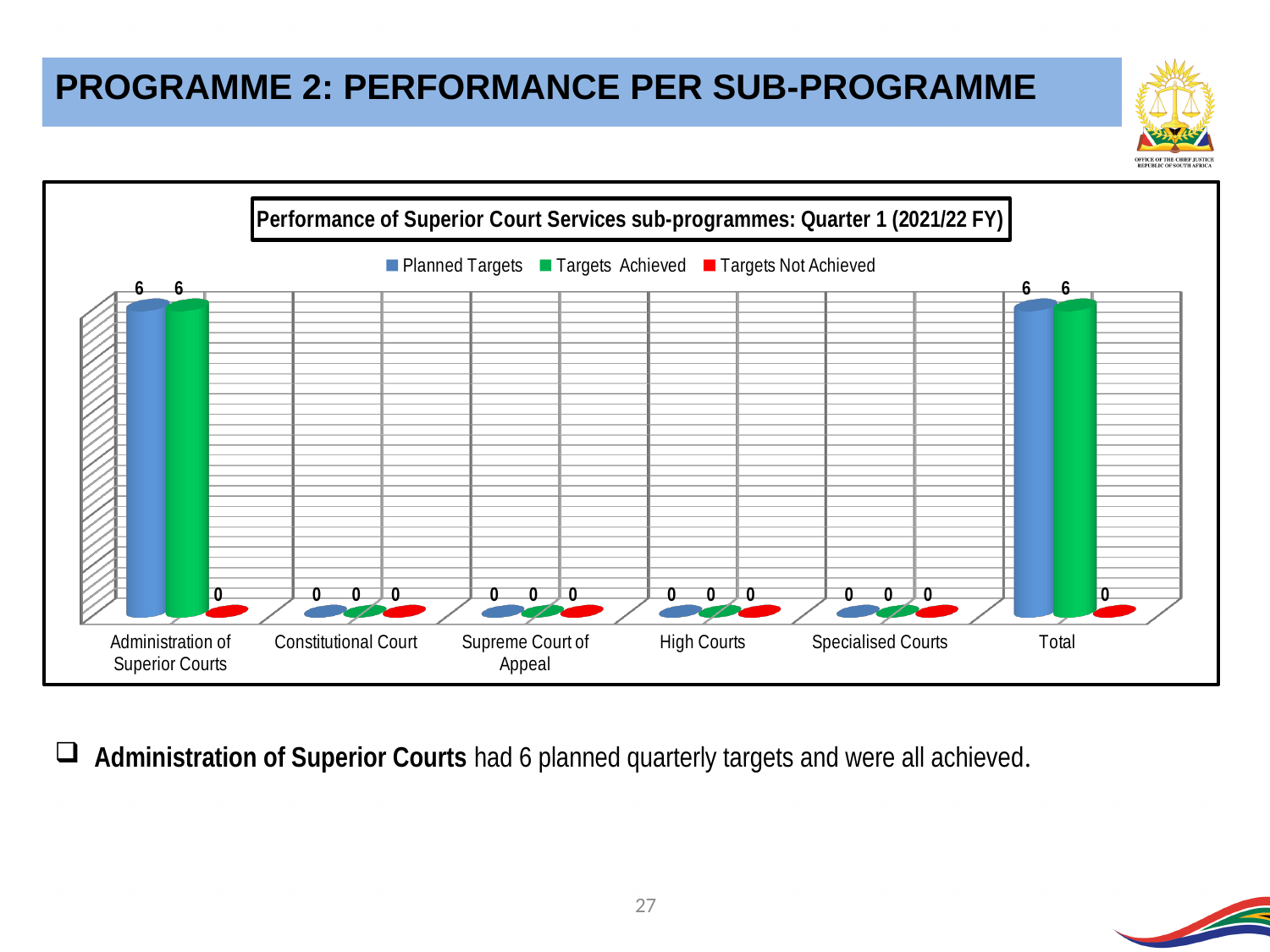
What is the Planned Targets value for Administration of Superior Courts? 6 What is the Targets Achieved value for Constitutional Court? 0 What kind of chart is shown on the slide? Bar chart What is the difference between Planned Targets and Targets Achieved for Administration of Superior Courts? 0 What is the Planned Targets value for High Courts? 0 Which is larger: Planned Targets for Administration of Superior Courts or Planned Targets for Supreme Court of Appeal? Administration of Superior Courts What is the Targets Achieved value for Total? 6 What is the Targets Not Achieved value for Administration of Superior Courts? 0 How many series does the legend list? 3 How many categories are shown on the x axis of the chart? 6 What is the title of the chart? Performance of Superior Court Services sub-programmes: Quarter 1 (2021/22 FY) What is the difference between Planned Targets for Total and Planned Targets for Specialised Courts? 6